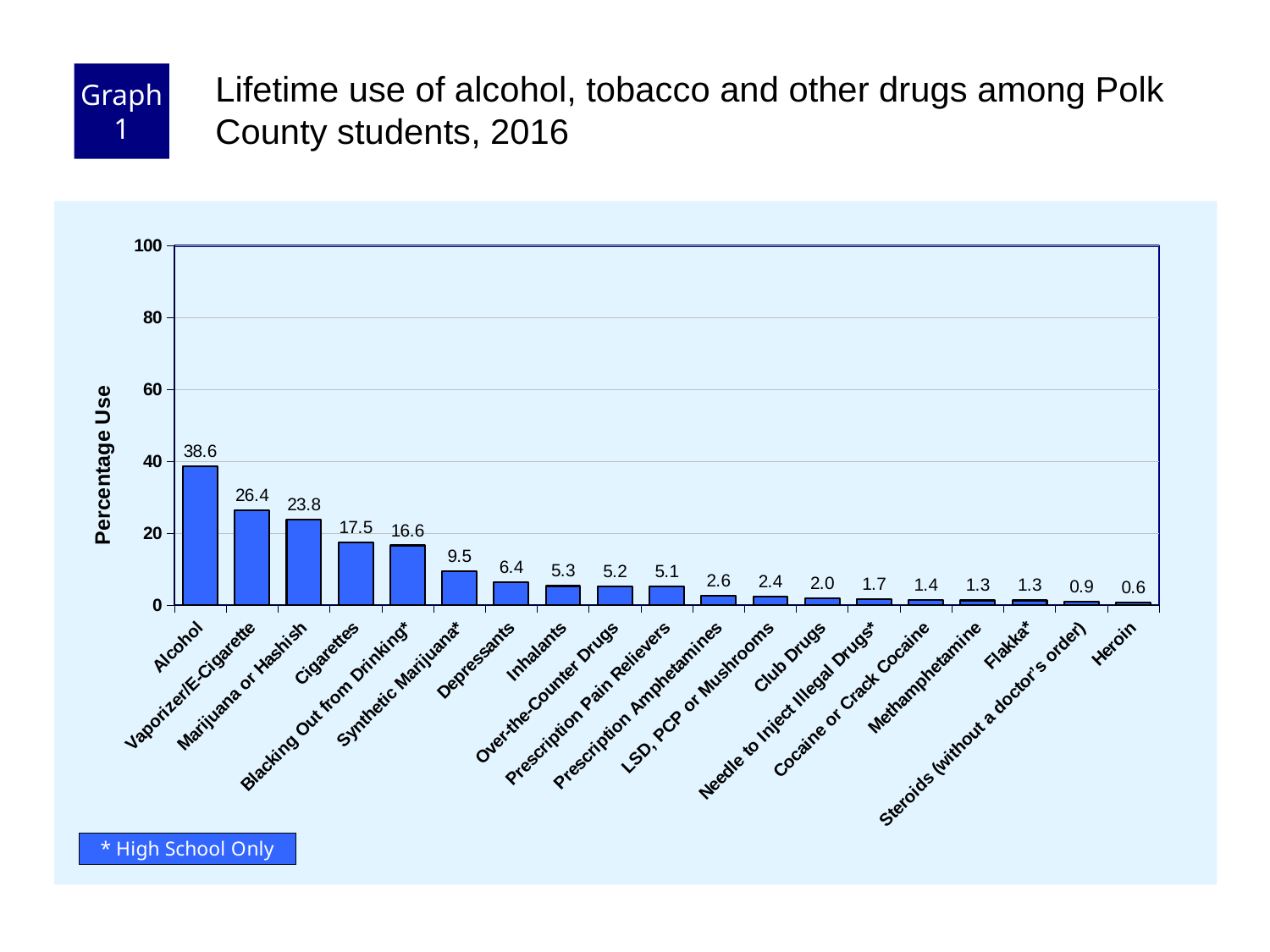
How many categories are shown on the x axis? 19 What is the percentage use for Alcohol? 38.6 Is the value for Blacking Out from Drinking* greater or less than 20? less What is the percentage use for Cigarettes? 17.5 What kind of chart is shown on the slide? bar chart What is the label of the y axis? Percentage Use What is the percentage use for Heroin? 0.6 What is the percentage use for Synthetic Marijuana*? 9.5 Which has a higher percentage use, Marijuana or Hashish or Cigarettes? Marijuana or Hashish Which category has the highest percentage use? Alcohol Which category has the lowest percentage use? Heroin What is the difference in percentage use between Alcohol and Vaporizer/E-Cigarette? 12.2